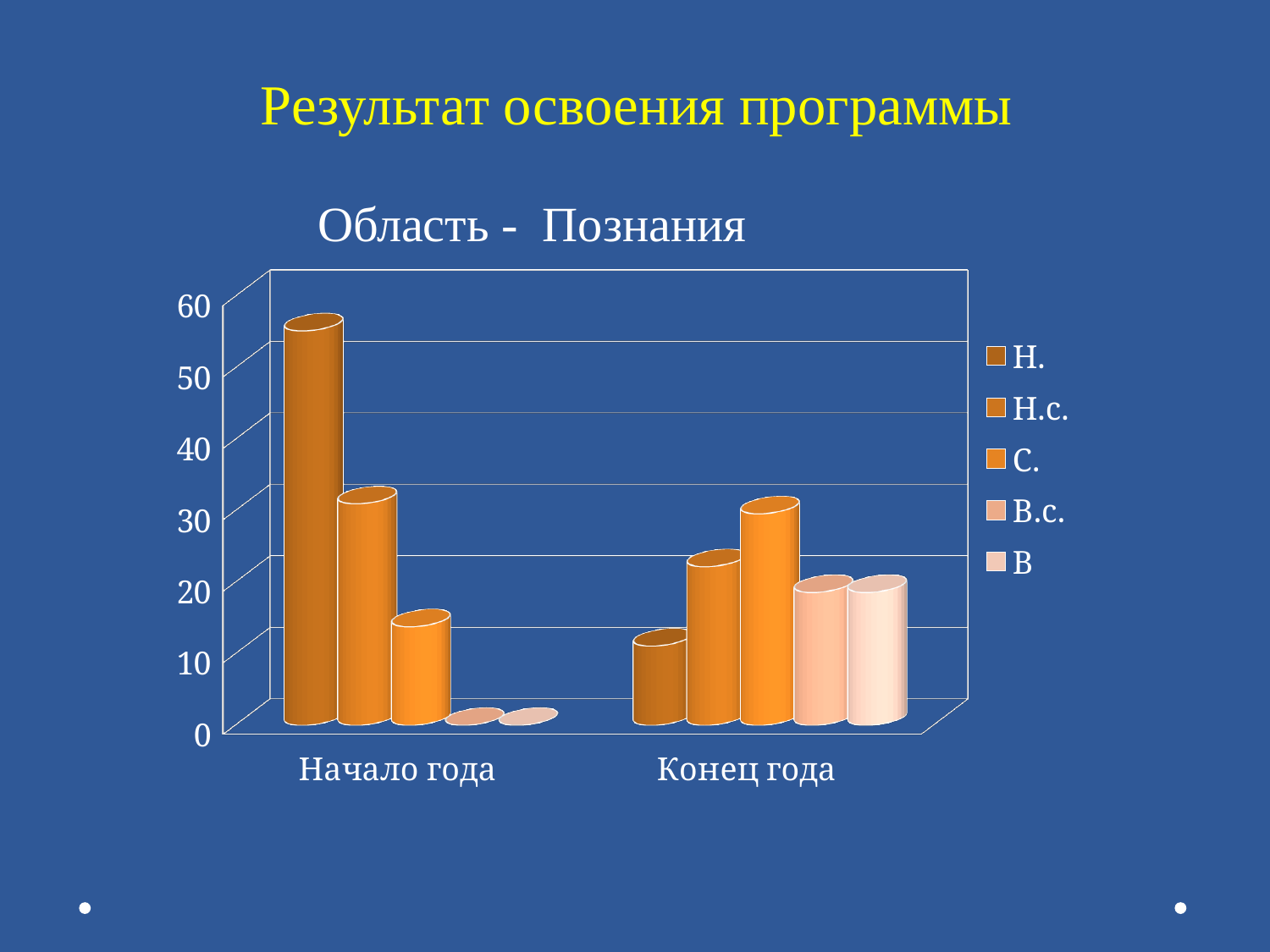
How many categories are shown on the x axis? 2 Which series has the lowest value for Конец года? Н. Is the value for Н. at Начало года greater or less than 50? greater What kind of chart is shown on the slide? bar chart Is the value for С. at Начало года greater or less than 20? less What is the title of the chart? Область - Познания Is the value for Н. at Конец года greater or less than 20? less Which series has the highest value for Начало года? Н. How many series does the legend list? 5 Which series has the highest value for Конец года? С. Does the value for С. rise or fall from Начало года to Конец года? rise Which is larger: the value for Н. at Начало года or at Конец года? Начало года